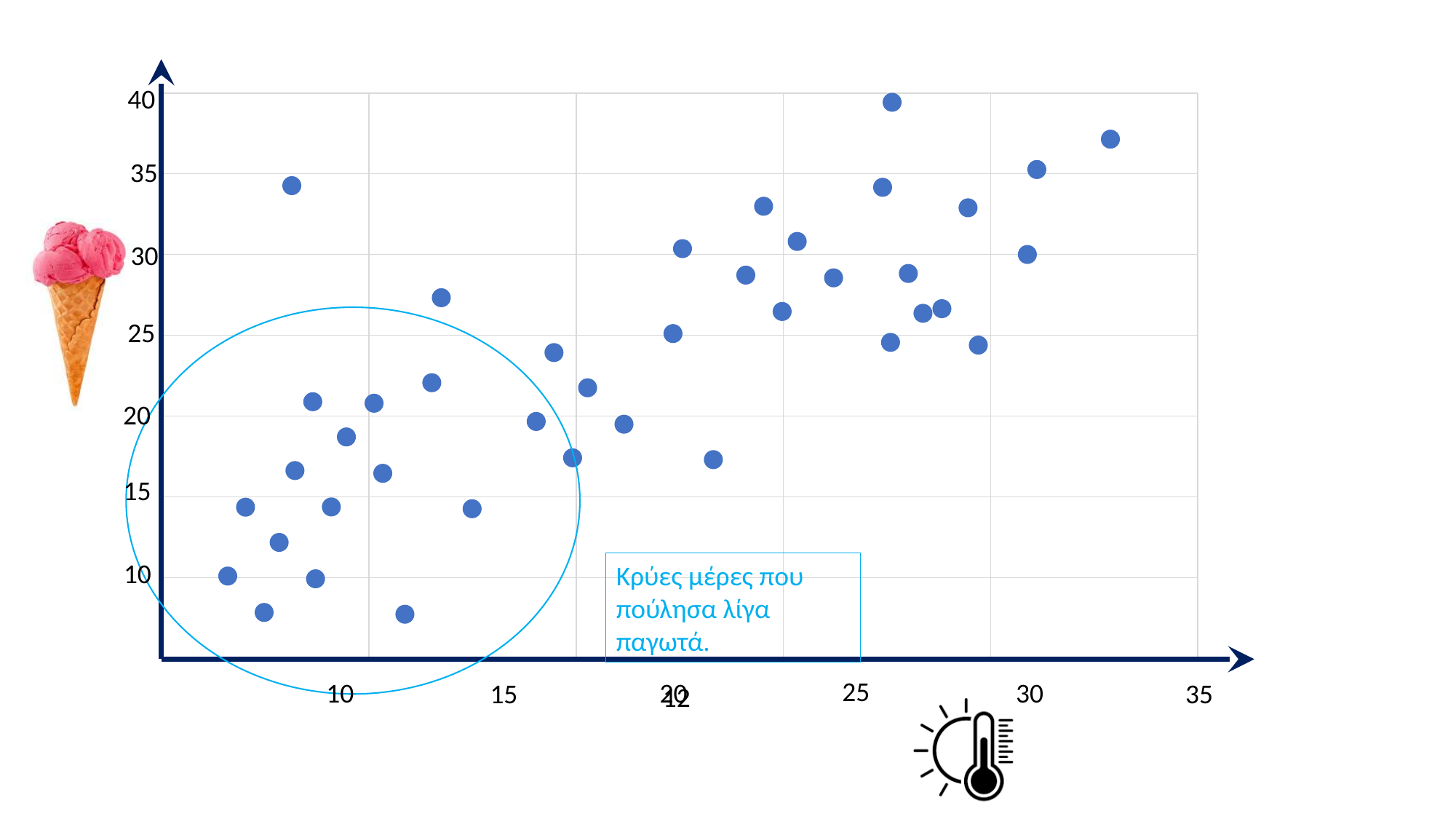
Is the y value of the rightmost point on the chart greater or less than 35? greater Is the x value of the rightmost point on the chart greater or less than 30? greater Do the y values generally rise or fall as the x values increase along the x axis? rise What text is written in the annotation box next to the circled group of points? Κρύες μέρες που πούλησα λίγα παγωτά. Is the y value of the lowest point on the chart greater or less than 10? less What is the largest value labelled on the y axis? 40 What kind of chart is shown on the slide? scatter plot